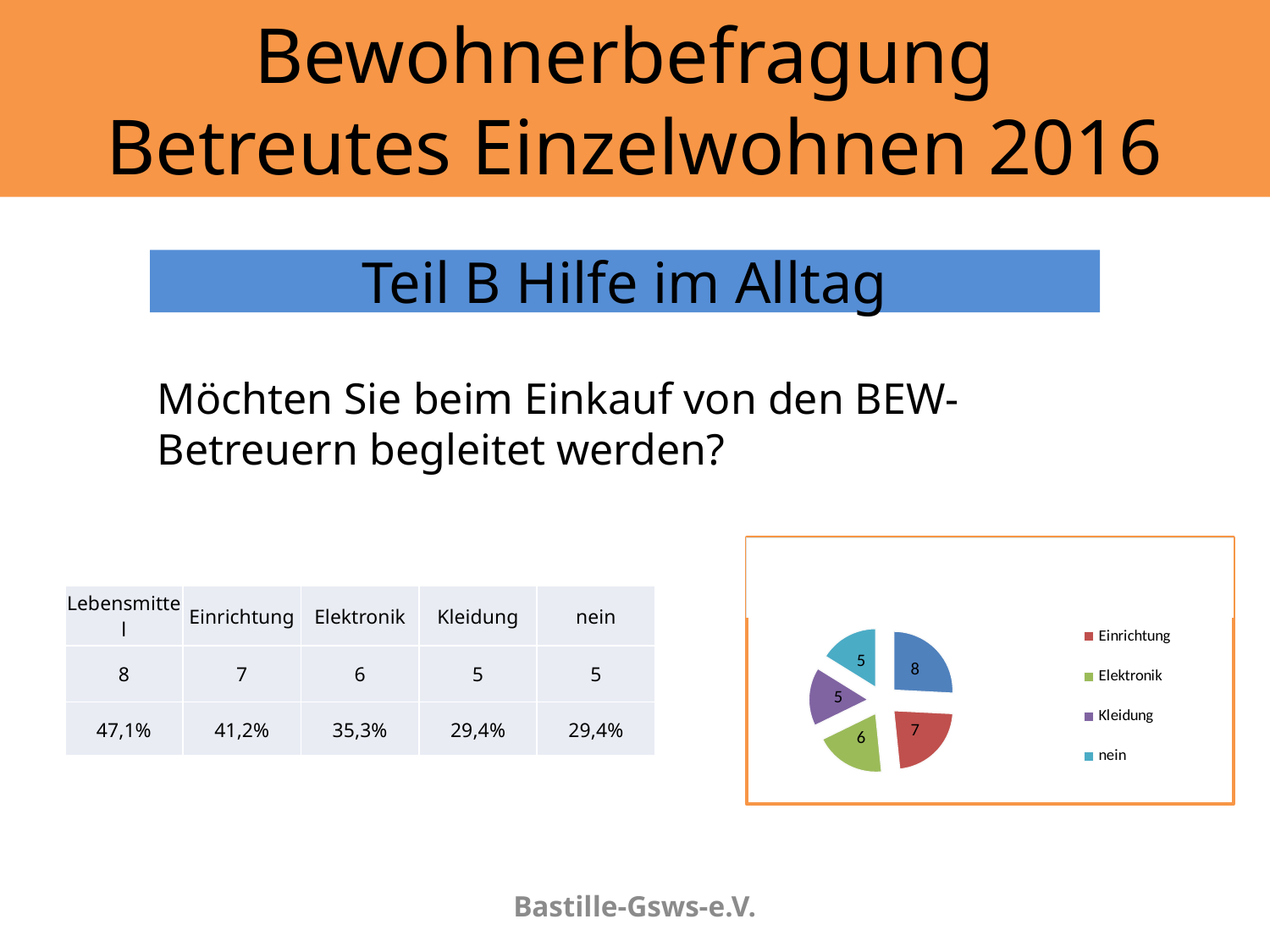
Which slice is larger in the pie chart, Einrichtung or Kleidung? Einrichtung What is the value shown on the nein slice of the pie chart? 5 What kind of chart is shown on the slide? pie chart How many slices does the pie chart have? 5 What is the value shown on the Elektronik slice of the pie chart? 6 What is the value of the largest slice in the pie chart? 8 Which slice is larger in the pie chart, Elektronik or nein? Elektronik What is the difference between the Einrichtung slice and the Elektronik slice in the pie chart? 1 What is the value shown on the Einrichtung slice of the pie chart? 7 Which legend entry is listed last in the pie chart's legend? nein What is the value shown on the Kleidung slice of the pie chart? 5 What colour is the Einrichtung slice in the pie chart? red